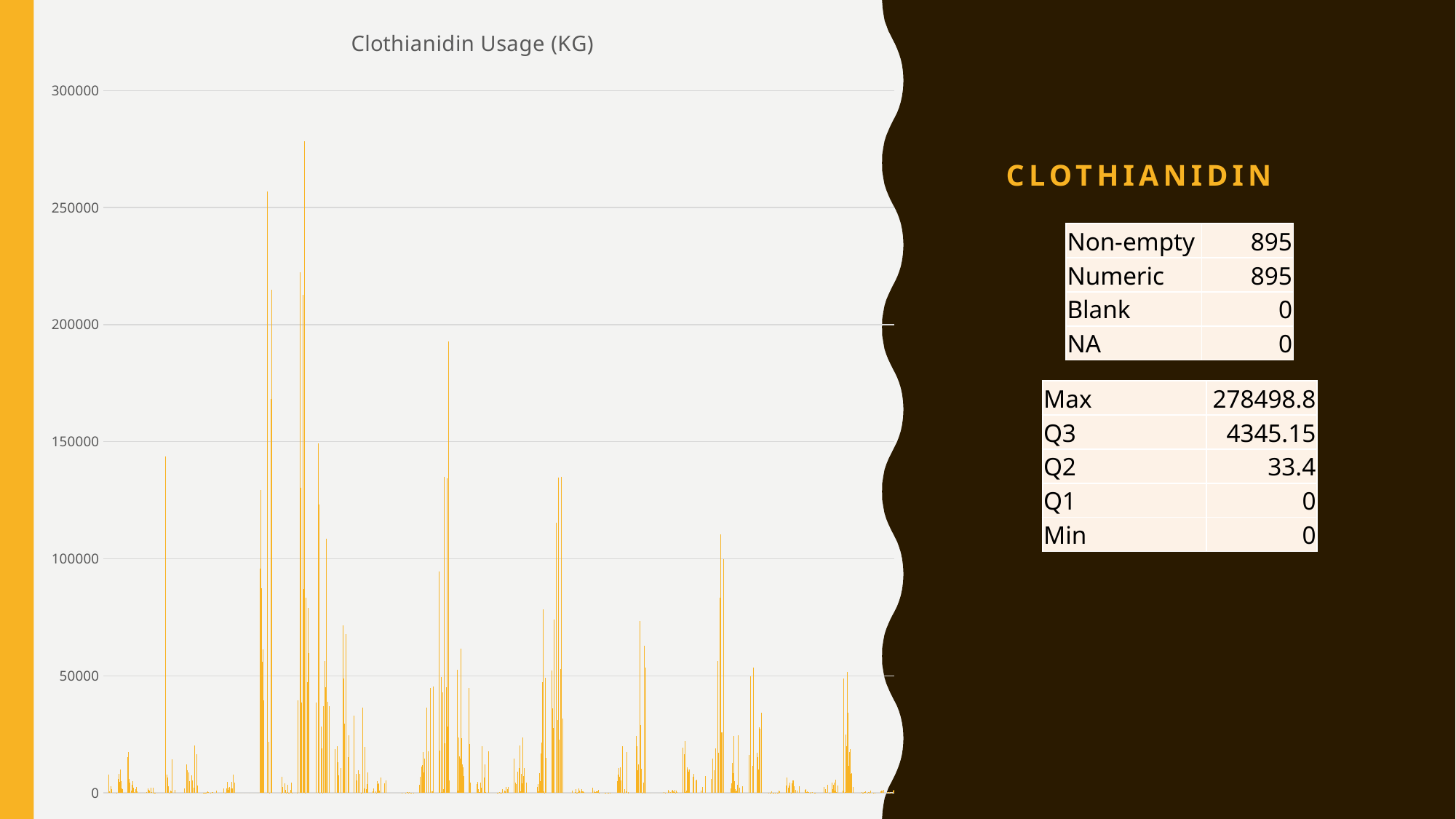
According to the slide, what is the maximum value plotted in the Clothianidin Usage chart? 278498.8 What is the highest tick value shown on the chart's vertical axis? 300000 Is the tallest bar in the chart greater or less than 300000? less What kind of chart is shown on the slide? bar chart Does the chart display a legend? No What is the title of the chart? Clothianidin Usage (KG) Is the tallest bar in the chart greater or less than 250000? greater According to the slide, how many numeric data points does the Clothianidin Usage chart plot? 895 According to the slide, what is the minimum value plotted in the Clothianidin Usage chart? 0